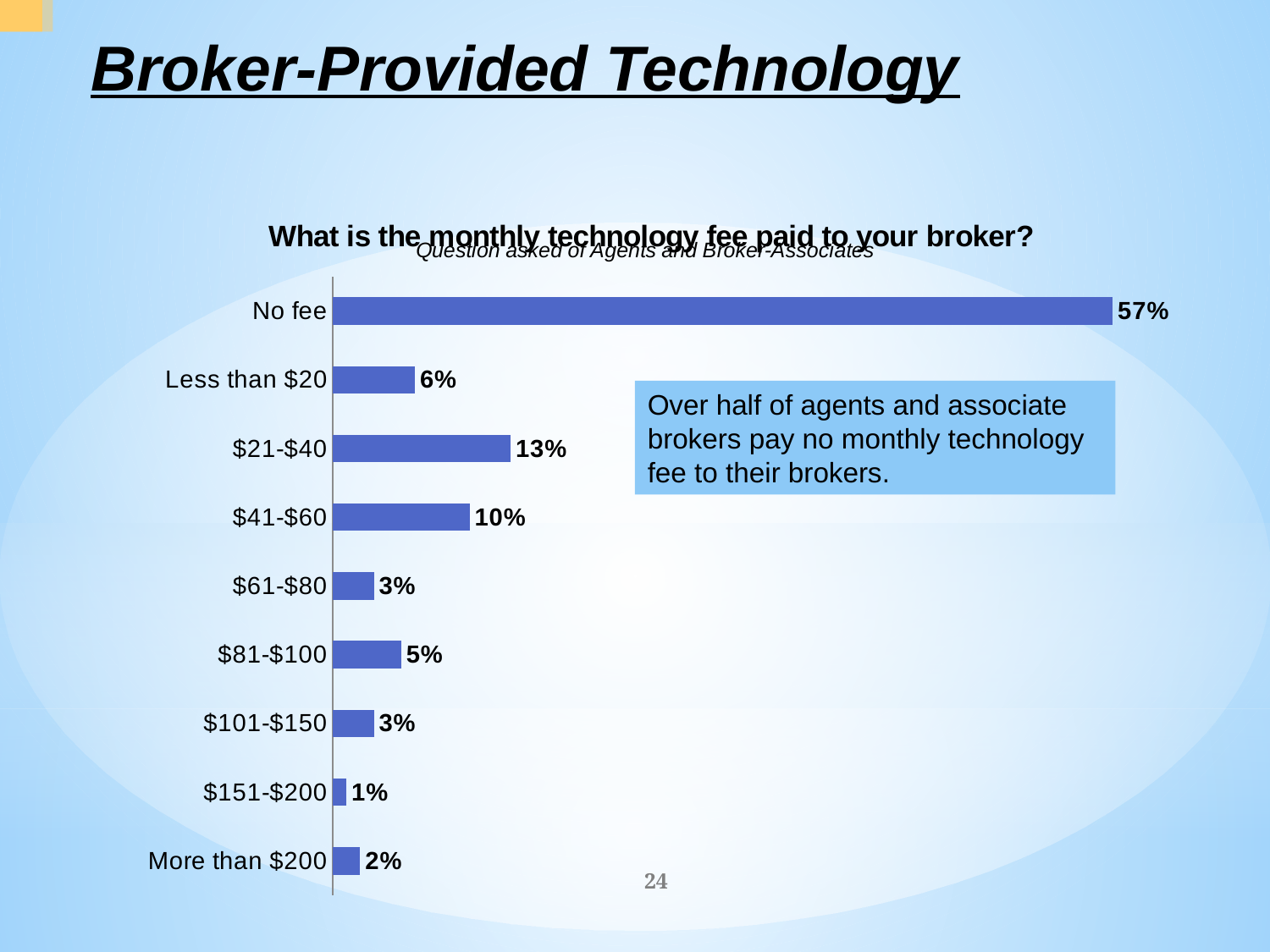
What is the value for the $21-$40 category? 13% What is the difference between the $41-$60 value and the $81-$100 value? 5% What kind of chart is shown on the slide? Bar chart What is the title of the chart? What is the monthly technology fee paid to your broker? What is the difference between the No fee value and the $21-$40 value? 44% Which is larger, the value for Less than $20 or the value for $81-$100? Less than $20 How many fee categories are shown in the chart? 9 What percentage of respondents pay no monthly technology fee to their broker? 57% What is the value for the More than $200 category? 2% What is the value for the $41-$60 category? 10% Which category has the highest value? No fee Which category has the lowest value? $151-$200